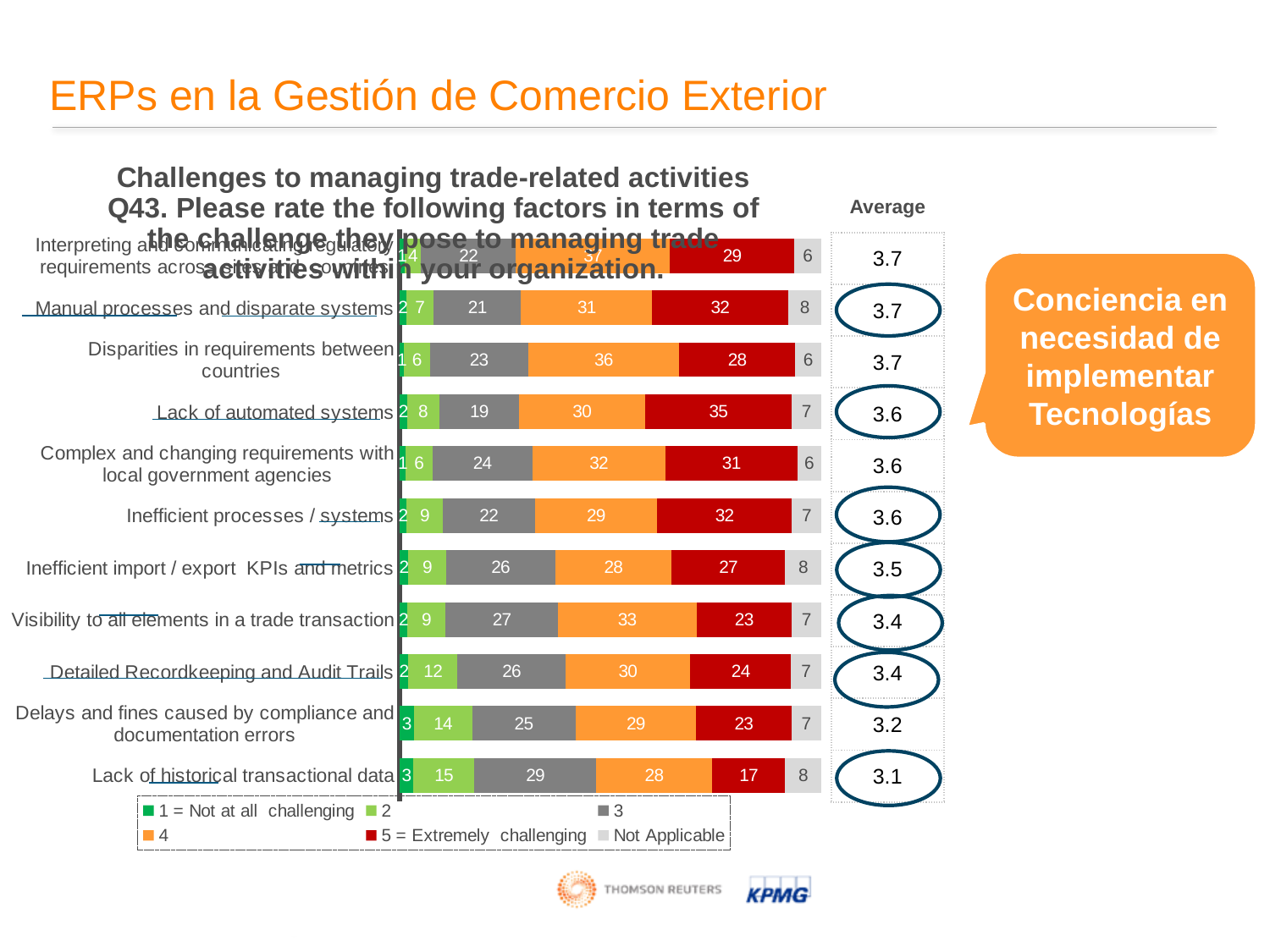
What is the Average shown for "Lack of historical transactional data"? 3.1 Which category has the lowest value in the "5 = Extremely challenging" series? Lack of historical transactional data What is the value of the "3" series for "Visibility to all elements in a trade transaction"? 27 Which category has the highest value in the "5 = Extremely challenging" series? Lack of automated systems What kind of chart is shown on the slide? Stacked bar chart Which has a larger value in the "4" series: "Disparities in requirements between countries" or "Lack of historical transactional data"? Disparities in requirements between countries How many series does the legend list? 6 What is the value of the "5 = Extremely challenging" series for "Lack of automated systems"? 35 How many categories are plotted in the chart? 11 What is the difference between the "5 = Extremely challenging" values for "Manual processes and disparate systems" and "Lack of historical transactional data"? 15 What is the total of the stacked bar for "Lack of historical transactional data"? 100 What is the "Not Applicable" value for "Detailed Recordkeeping and Audit Trails"? 7